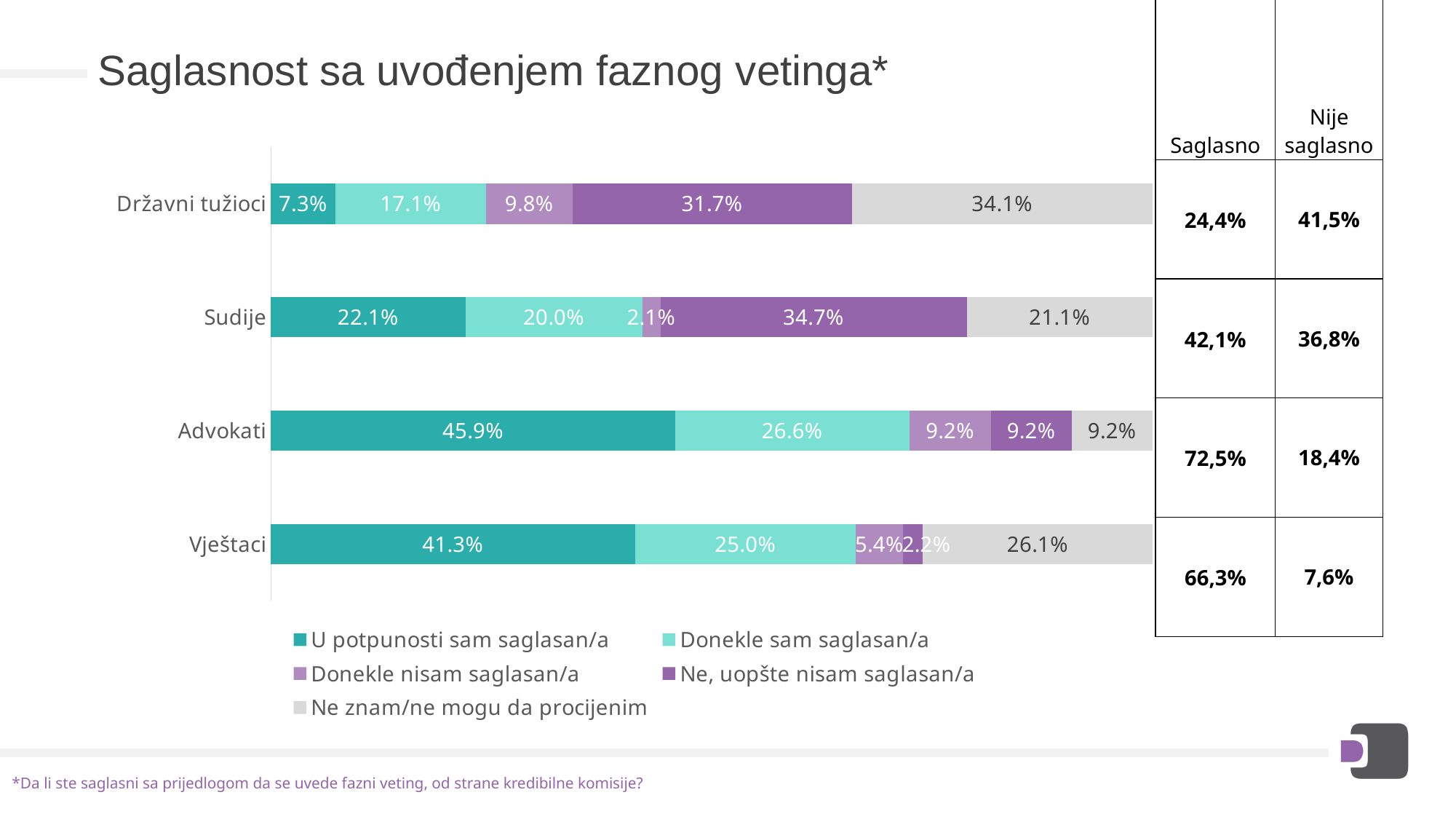
What is the value for Državni tužioci in the "Ne znam/ne mogu da procijenim" series? 34.1% How many series does the legend list? 5 Which category has the lowest value in the "U potpunosti sam saglasan/a" series? Državni tužioci What is the difference between the "U potpunosti sam saglasan/a" values for Advokati and Vještaci? 4.6 percentage points What is the value for Advokati in the "U potpunosti sam saglasan/a" series? 45.9% What kind of chart is shown on the slide? Stacked bar chart How many categories are shown on the chart? 4 What is the value for Sudije in the "Ne, uopšte nisam saglasan/a" series? 34.7% Which is larger: the "Donekle sam saglasan/a" value for Sudije or for Državni tužioci? Sudije Which category has the highest value in the "U potpunosti sam saglasan/a" series? Advokati What is the title of the chart on the slide? Saglasnost sa uvođenjem faznog vetinga* What is the value for Vještaci in the "Donekle sam saglasan/a" series? 25.0%